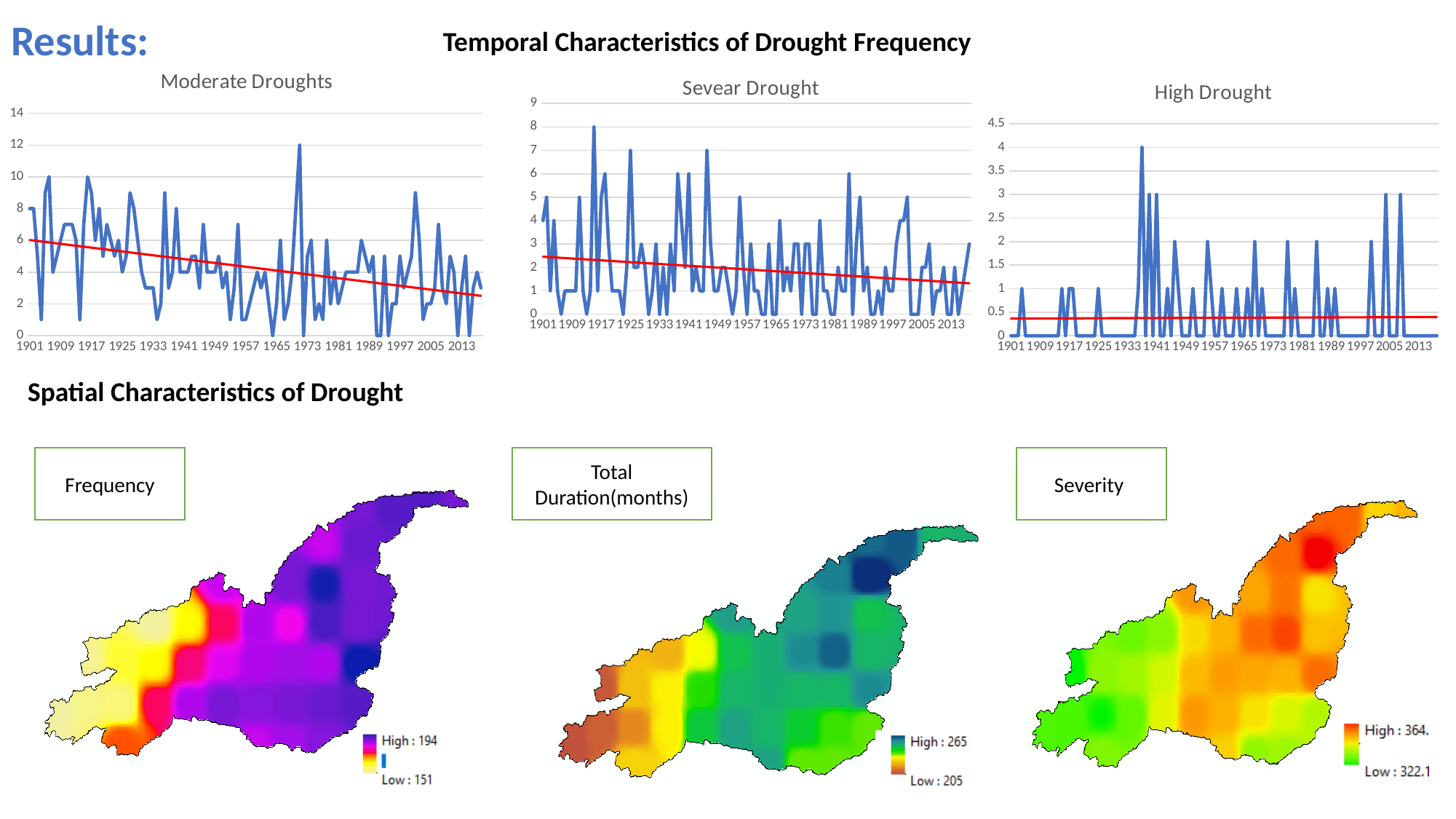
What is the title of the middle line chart at the top of the slide? Sevear Drought On the Moderate Droughts chart, what is the highest value reached by the line? 12 On the Moderate Droughts chart, does the red trend line rise or fall from 1901 to 2013? fall What kind of chart is the Moderate Droughts chart? line chart On the Sevear Drought chart, what is the highest value reached by the line? 8 On the Frequency map legend, what is the High value? 194 On the High Drought chart, is the peak value greater or less than 3.5? greater How many line charts are shown under the heading 'Temporal Characteristics of Drought Frequency'? 3 What colour is the trend line drawn on each of the three line charts? red On the High Drought chart, what is the highest value reached by the line? 4 On the Sevear Drought chart, does the red trend line rise or fall across the years? fall On the Moderate Droughts chart, is the peak value greater or less than 10? greater